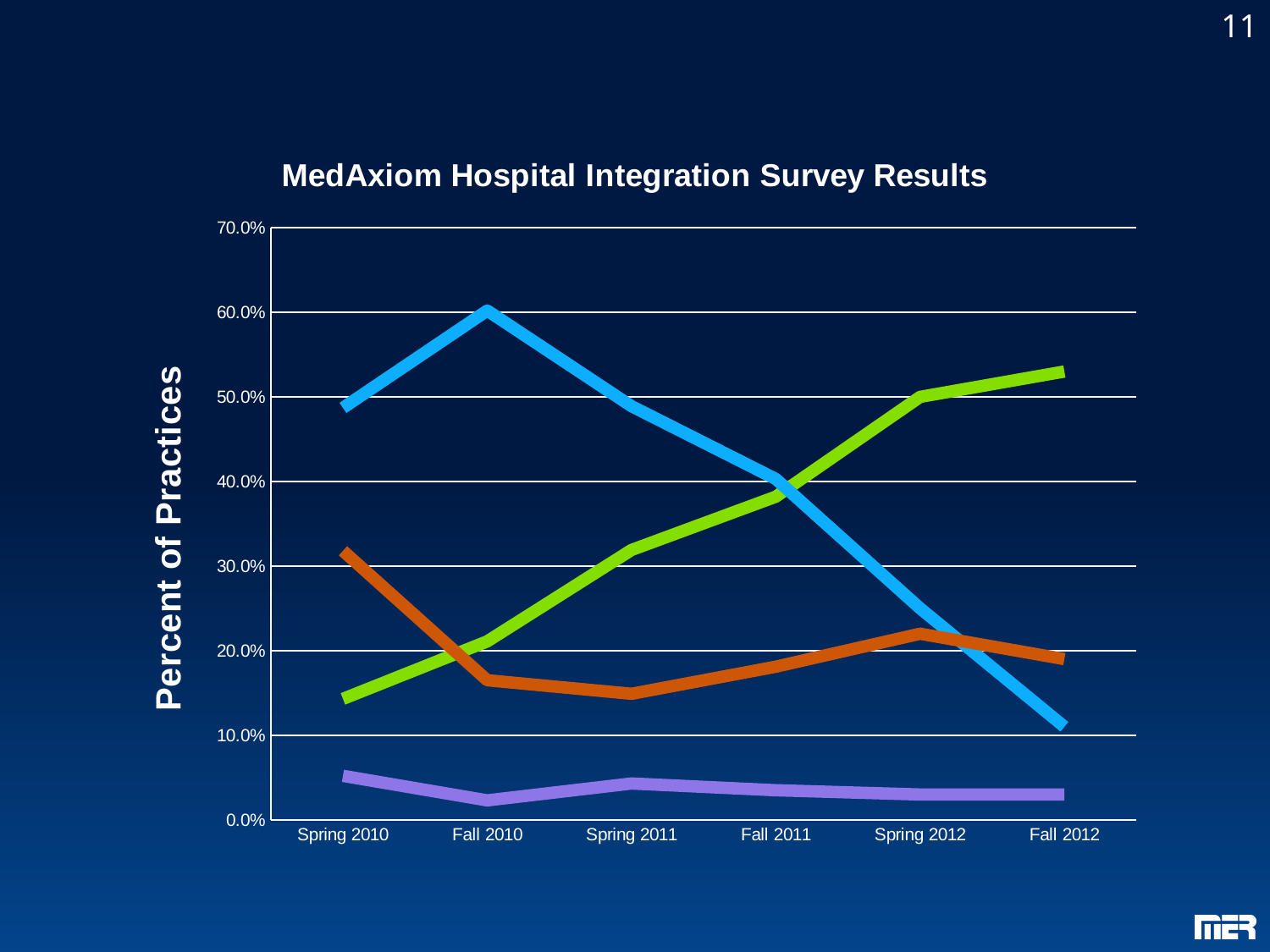
In which survey period does the green line reach its highest value? Fall 2012 Is the value of the green line at Spring 2010 greater or less than 20.0%? less Does the green line rise or fall from Spring 2010 to Fall 2012? rise How many lines are plotted on the chart? 4 What kind of chart is shown on the slide? line chart What is the title of the chart? MedAxiom Hospital Integration Survey Results How many survey periods are shown along the x axis? 6 Is the value of the blue line at Fall 2010 greater or less than 50.0%? greater What is the label on the vertical axis? Percent of Practices At Fall 2012, which line has the larger value, the green line or the blue line? green line In which survey period does the blue line reach its highest value? Fall 2010 In which survey period is the blue line at its lowest value? Fall 2012